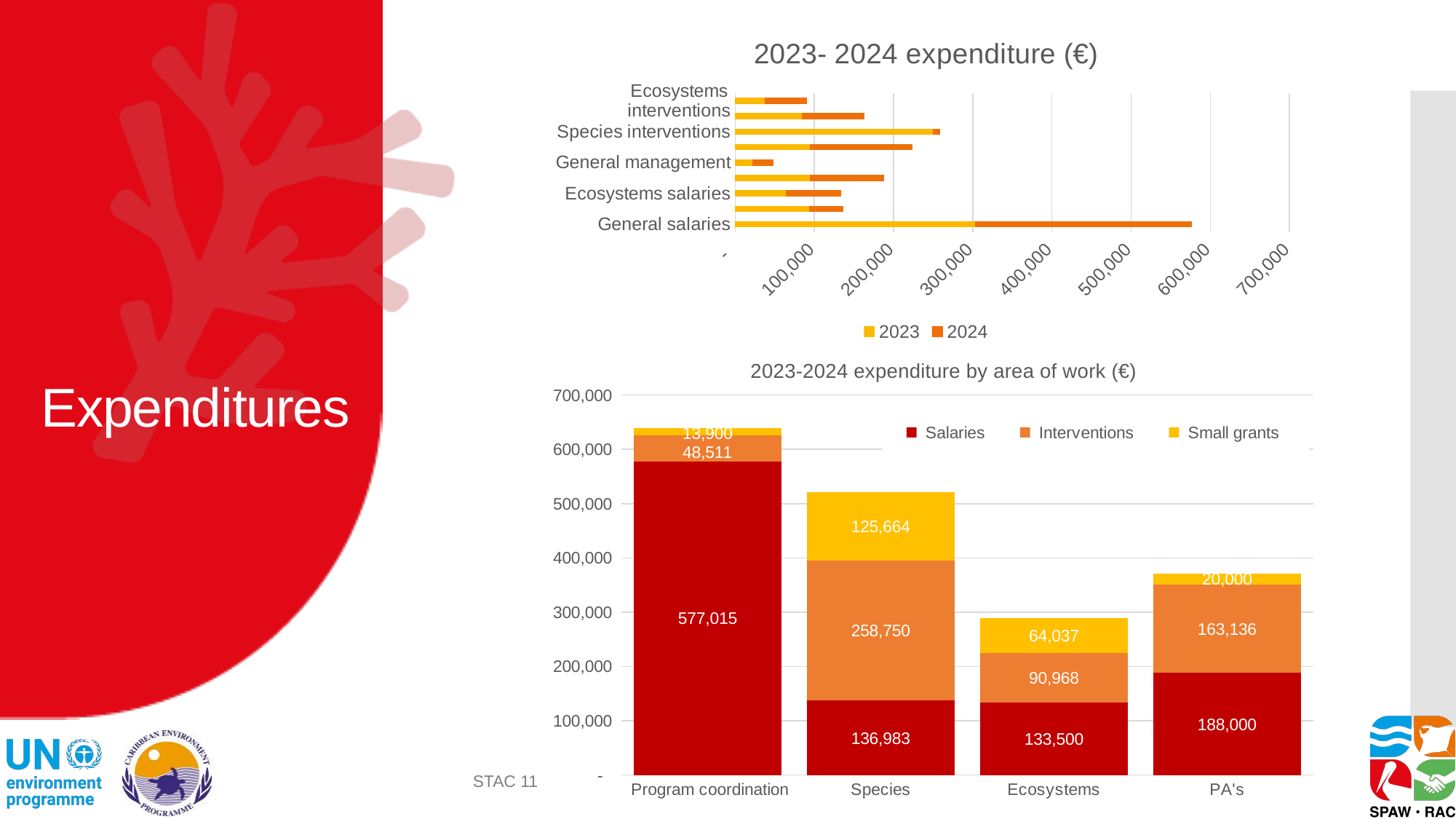
In the chart titled "2023-2024 expenditure by area of work (€)", what is the Salaries value for Program coordination? 577,015 In the chart titled "2023-2024 expenditure by area of work (€)", what is the Interventions value for PA's? 163,136 In the chart titled "2023-2024 expenditure by area of work (€)", which has the larger Salaries value, Ecosystems or PA's? PA's In the chart titled "2023-2024 expenditure by area of work (€)", what is the Small grants value for Species? 125,664 In the chart titled "2023-2024 expenditure by area of work (€)", what kind of chart is shown? Stacked bar chart In the chart titled "2023-2024 expenditure by area of work (€)", what is the difference between the Interventions values for Species and Ecosystems? 167,782 In the chart titled "2023- 2024 expenditure (€)", is the total bar length for General salaries greater or less than 500,000? greater In the chart titled "2023-2024 expenditure by area of work (€)", how many areas of work are shown on the x axis? 4 In the chart titled "2023-2024 expenditure by area of work (€)", which area of work has the highest Salaries value? Program coordination In the chart titled "2023-2024 expenditure by area of work (€)", what is the total of the stacked bar for Ecosystems? 288,505 In the chart titled "2023-2024 expenditure by area of work (€)", how many series does the legend list? 3 In the chart titled "2023-2024 expenditure by area of work (€)", which area of work has the lowest Small grants value? Program coordination